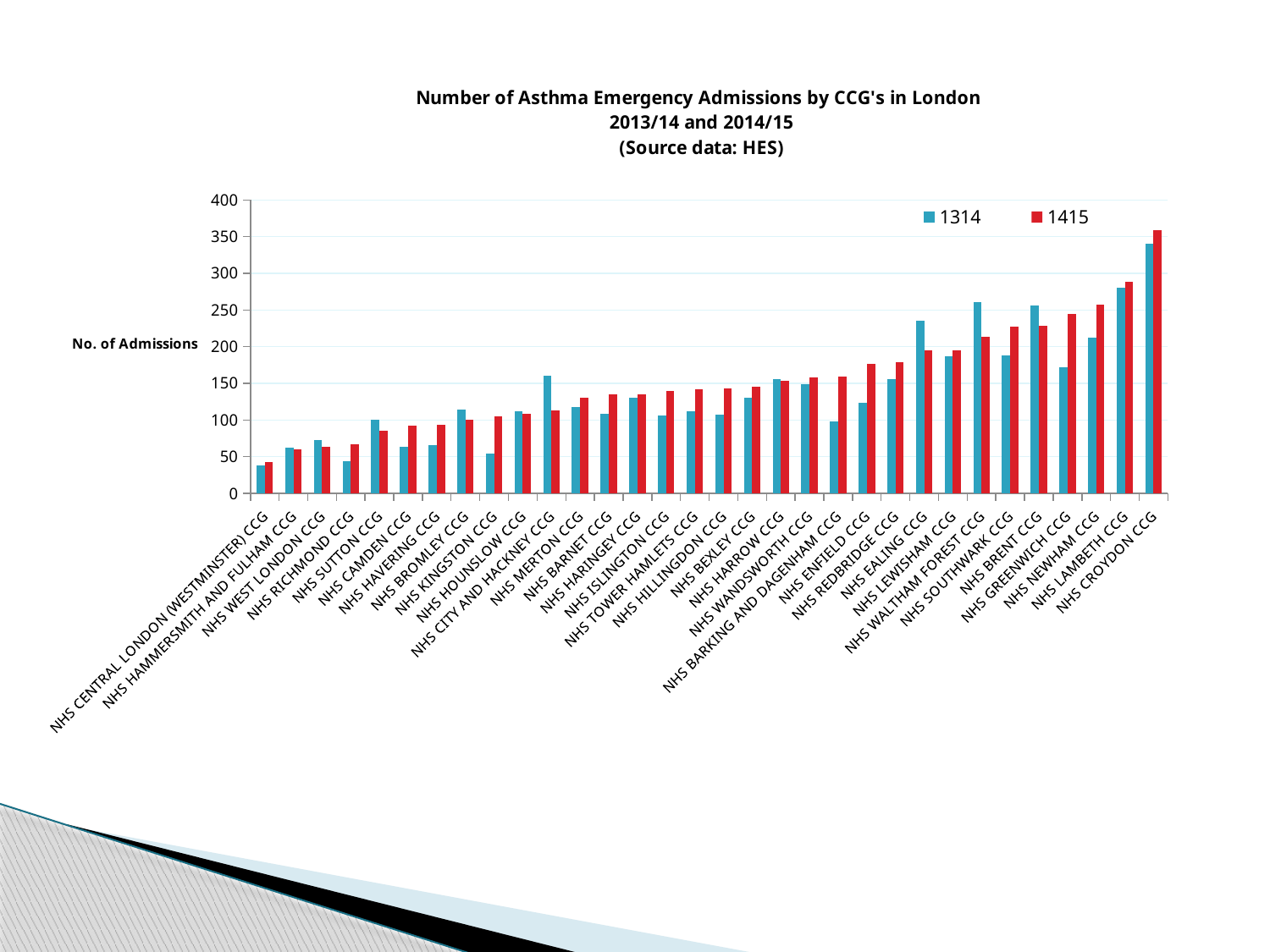
Which CCG has the lowest number of admissions in the 1314 series? NHS Central London (Westminster) CCG Is the 1314 value for NHS Central London (Westminster) CCG greater or less than 50? less Which CCG has the highest number of admissions in the 1415 series? NHS Croydon CCG Do the 1415 values generally rise or fall from left to right along the x axis? rise Is the 1415 value for NHS Lambeth CCG greater or less than 300? less For NHS Southwark CCG, which series has the larger value, 1314 or 1415? 1415 How many series does the legend list? 2 How many CCGs are shown on the x axis? 32 What kind of chart is shown on the slide? bar chart For NHS City and Hackney CCG, which series has the larger value, 1314 or 1415? 1314 Is the 1415 value for NHS Croydon CCG greater or less than 350? greater